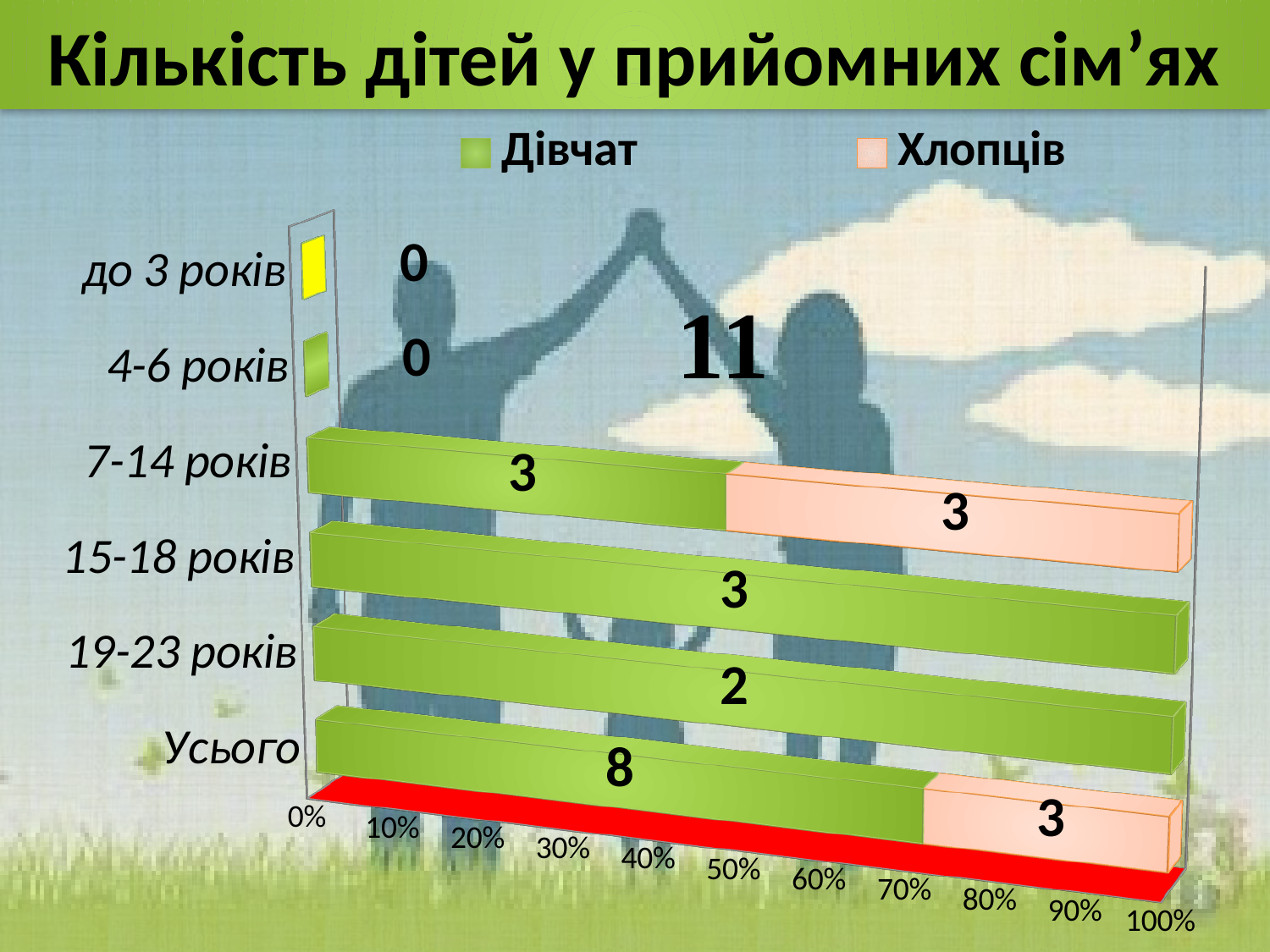
How many series does the legend list? 2 In the Усього category, which is larger: Дівчат or Хлопців? Дівчат What is the value for Дівчат in the 19-23 років category? 2 How many age categories are shown on the vertical axis? 6 What type of chart is shown on the slide? bar chart What are the two series named in the legend? Дівчат and Хлопців What is the total of the Усього bar (Дівчат plus Хлопців)? 11 What is the value for Хлопців in the 7-14 років category? 3 What is the value for Дівчат in the Усього category? 8 What is the value for Хлопців in the Усього category? 3 What is the value for Дівчат in the 7-14 років category? 3 What is the difference between Дівчат and Хлопців in the Усього category? 5